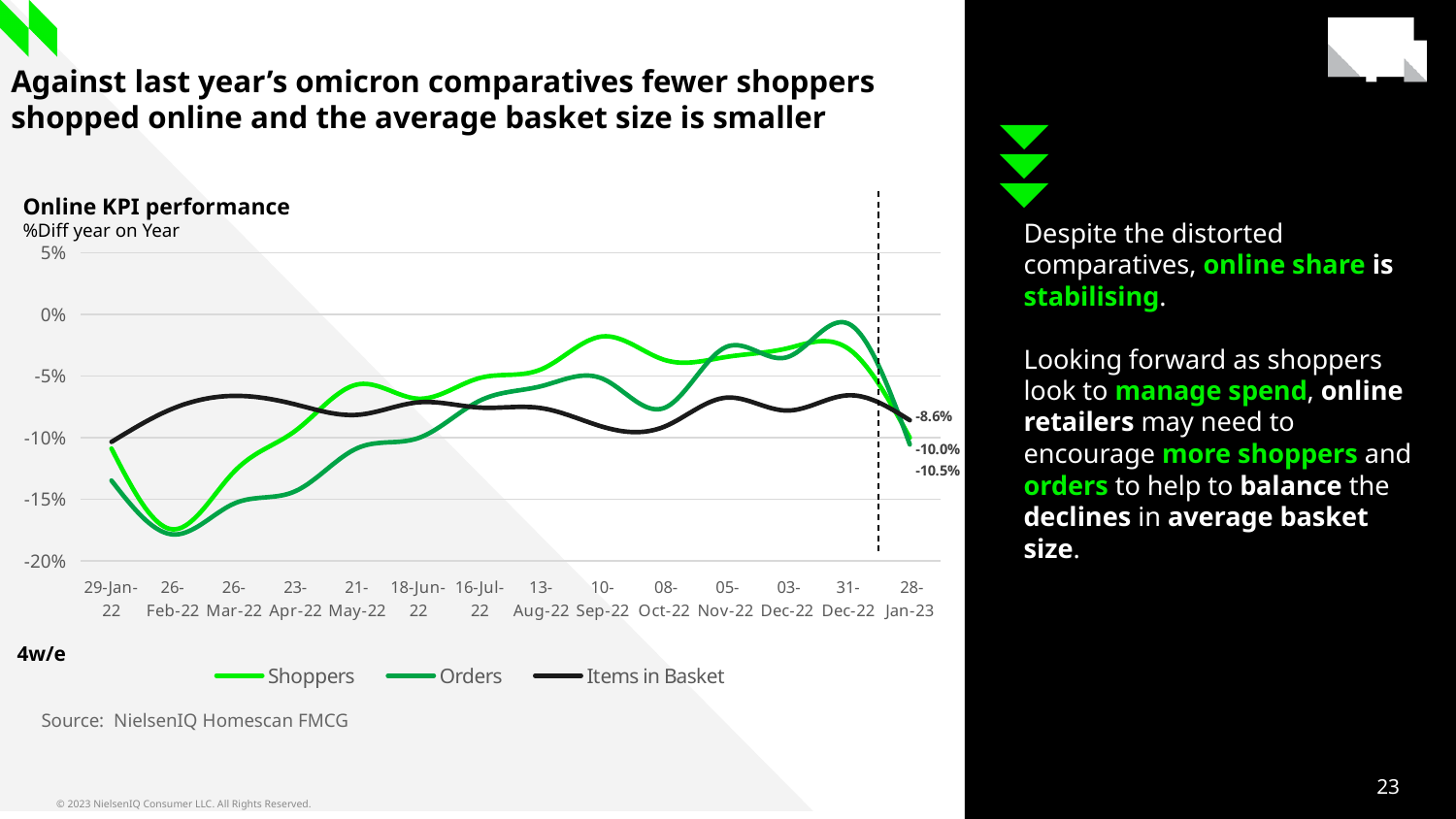
What kind of chart is shown on the slide? line chart Is the value for Shoppers at 29-Jan-22 greater or less than -5%? less Which series has the highest value at 10-Sep-22? Shoppers Is the value for Orders at 26-Feb-22 greater or less than -15%? less What is the value for Items in Basket at 28-Jan-23 in the Online KPI performance chart? -8.6% Is the value for Items in Basket at 26-Mar-22 greater or less than -10%? greater At 26-Feb-22, which is higher: Items in Basket or Orders? Items in Basket What is the title of the chart on the slide? Online KPI performance How many dates are labelled on the x axis of the Online KPI performance chart? 14 How many series does the legend of the Online KPI performance chart list? 3 Does the Items in Basket line rise or fall between 29-Jan-22 and 26-Mar-22? rise